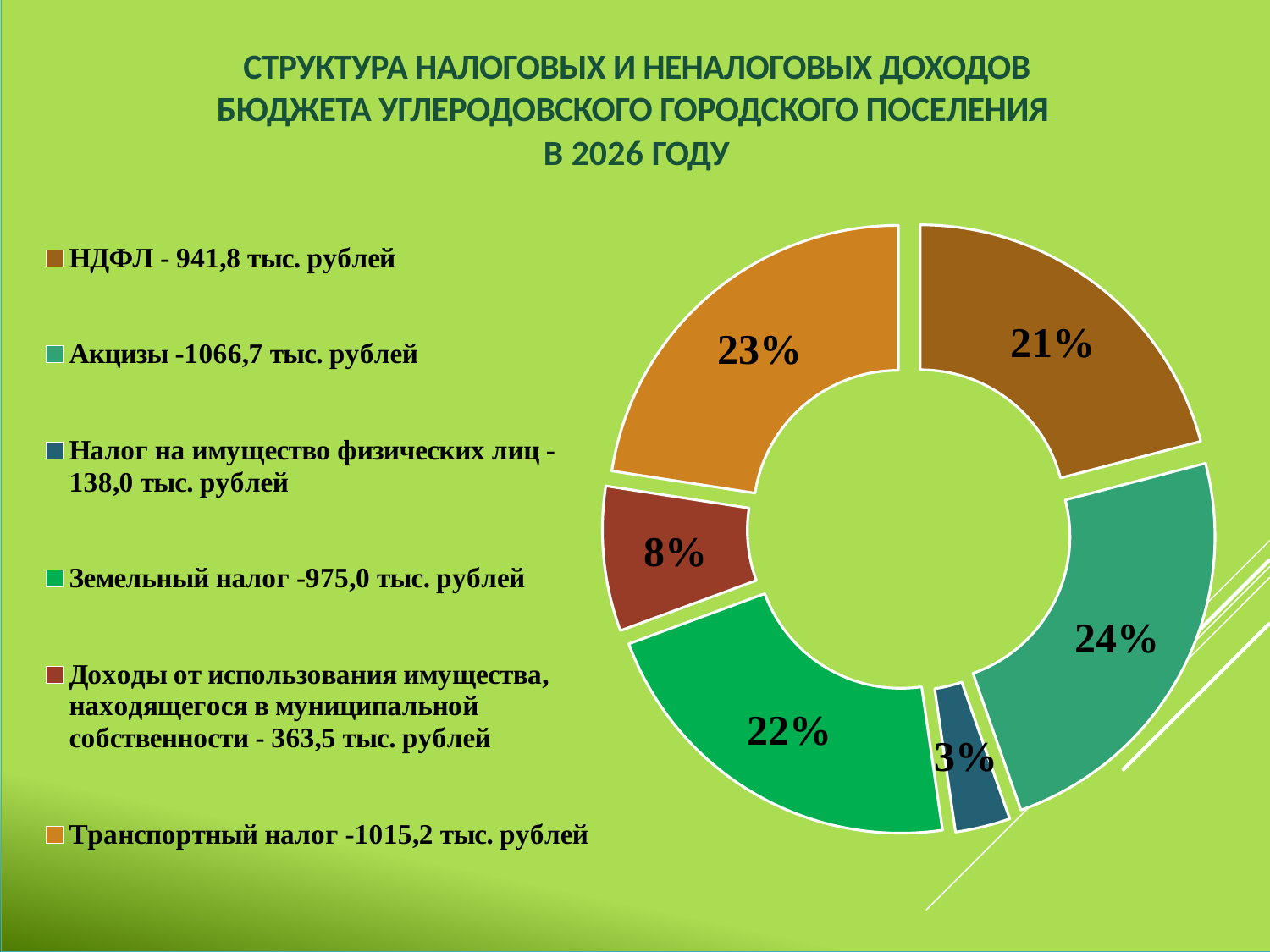
Which category has the largest share of the chart? Акцизы What is the difference in percentage points between Транспортный налог and Доходы от использования имущества, находящегося в муниципальной собственности? 15 What share of the chart does Акцизы account for? 24% Which category has the smallest share of the chart? Налог на имущество физических лиц Which has a larger share, Земельный налог or Транспортный налог? Транспортный налог What percentage is shown for Транспортный налог? 23% What type of chart is shown on the slide? Doughnut chart How many categories are shown in the chart? 6 According to the legend, what is the amount for Налог на имущество физических лиц? 138,0 тыс. рублей What percentage is shown for НДФЛ? 21% What percentage is shown for Земельный налог? 22% According to the legend, what is the amount for Земельный налог? 975,0 тыс. рублей